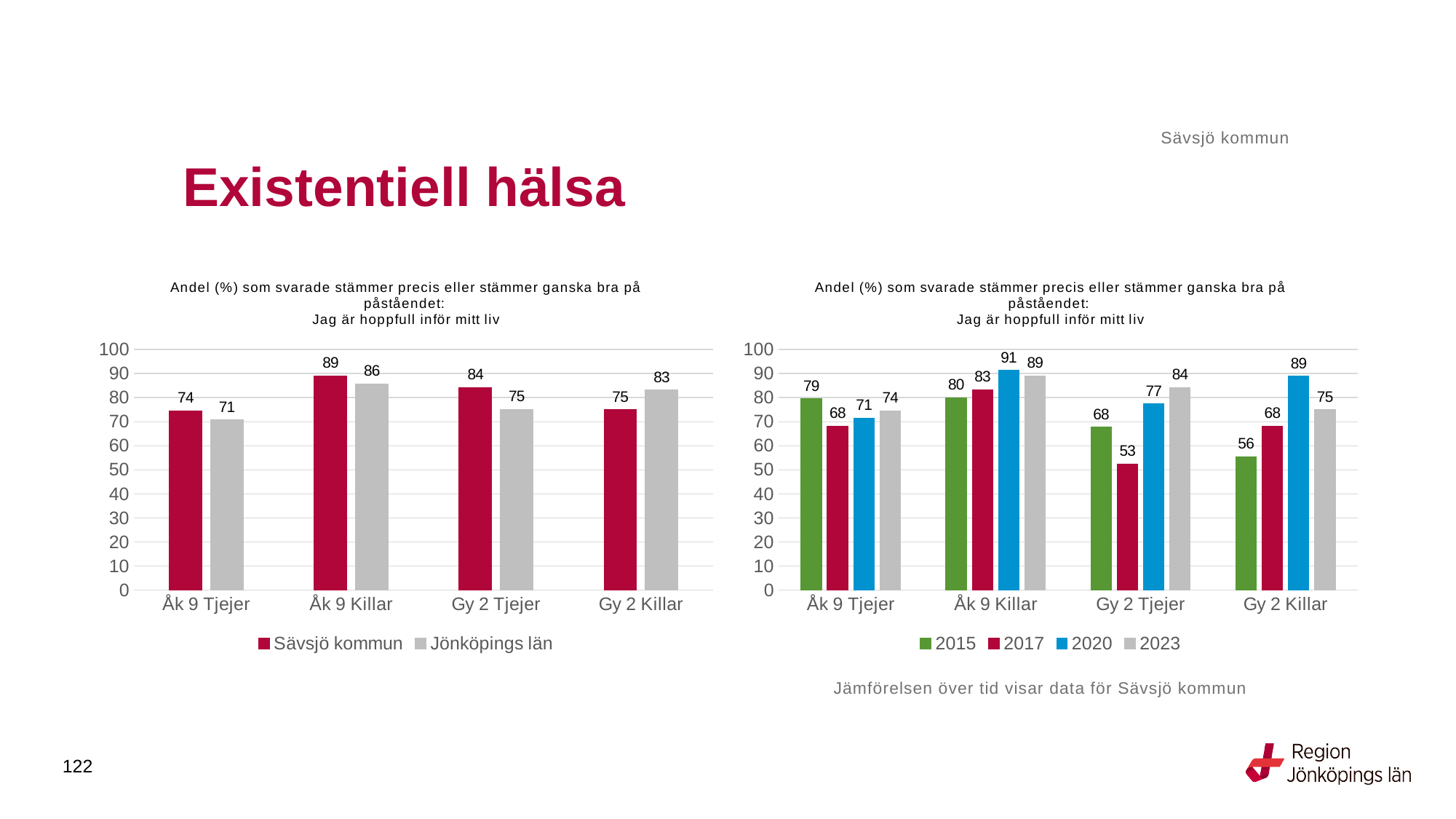
In the right chart, what is the value for 2017 for Gy 2 Tjejer? 53 In the left chart, which category has the lowest value for Sävsjö kommun? Åk 9 Tjejer What kind of chart is the right chart? Bar chart How many series does the legend of the left chart list? 2 In the left chart, what is the difference between Sävsjö kommun and Jönköpings län for Gy 2 Tjejer? 9 In the right chart, what is the difference between 2015 and 2023 for Gy 2 Killar? 19 In the right chart, which category has the highest value for 2020? Åk 9 Killar How many series does the legend of the right chart list? 4 In the left chart, what is the value for Jönköpings län for Gy 2 Tjejer? 75 In the right chart, what is the value for 2020 for Gy 2 Killar? 89 In the left chart, what is the value for Sävsjö kommun for Åk 9 Killar? 89 In the left chart, which is larger for Gy 2 Killar: Sävsjö kommun or Jönköpings län? Jönköpings län